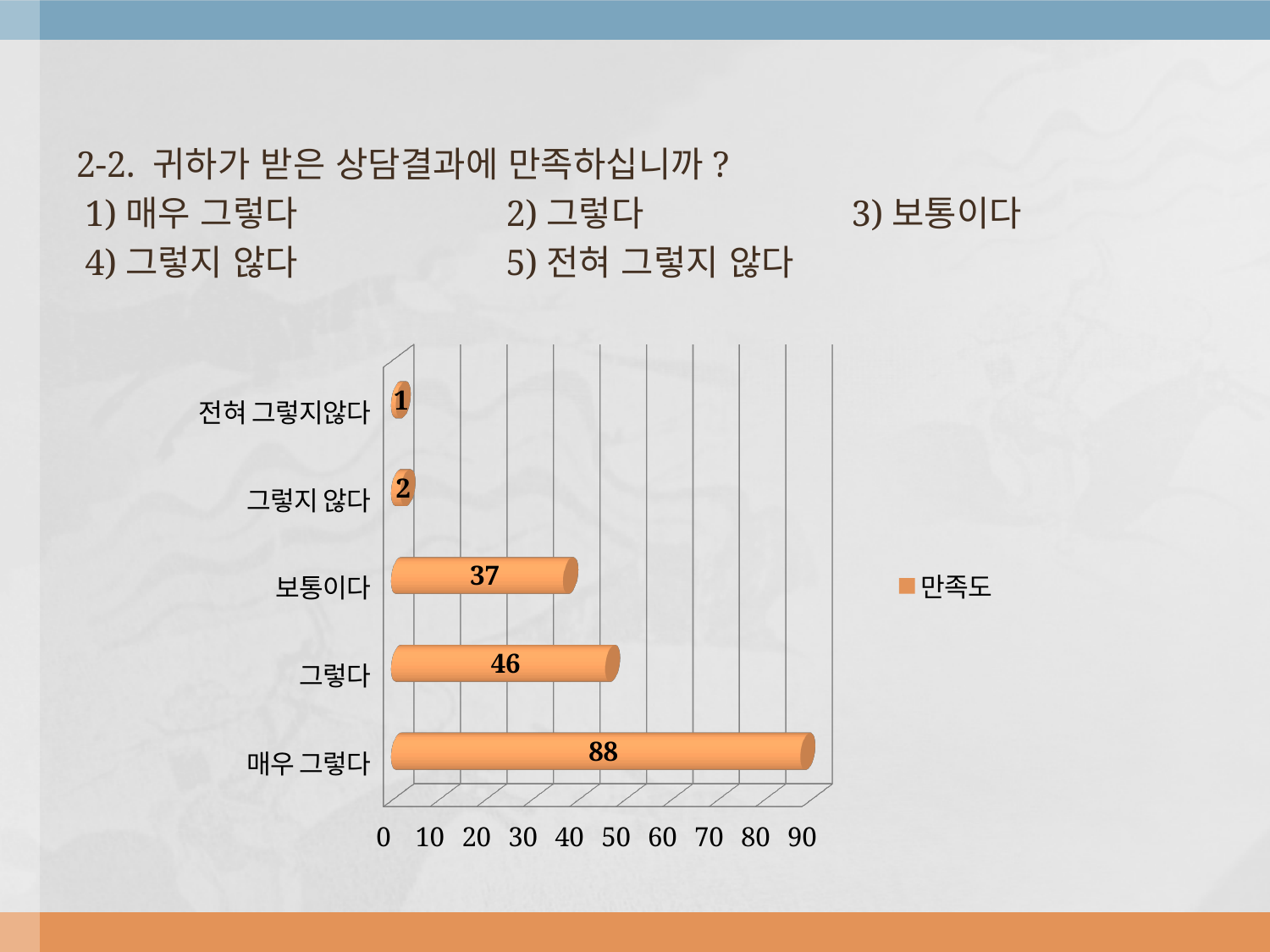
What is the difference between the values for 매우 그렇다 and 그렇다? 42 What is the value for 매우 그렇다? 88 What is the value for 그렇다? 46 Which is larger, the value for 그렇다 or the value for 보통이다? 그렇다 Which category has the lowest value? 전혀 그렇지않다 What is the value for 보통이다? 37 Which category has the highest value? 매우 그렇다 What is the value for 전혀 그렇지않다? 1 What kind of chart is shown on the slide? bar chart How many categories are shown in the chart? 5 What is the value for 그렇지 않다? 2 What series name does the legend show? 만족도